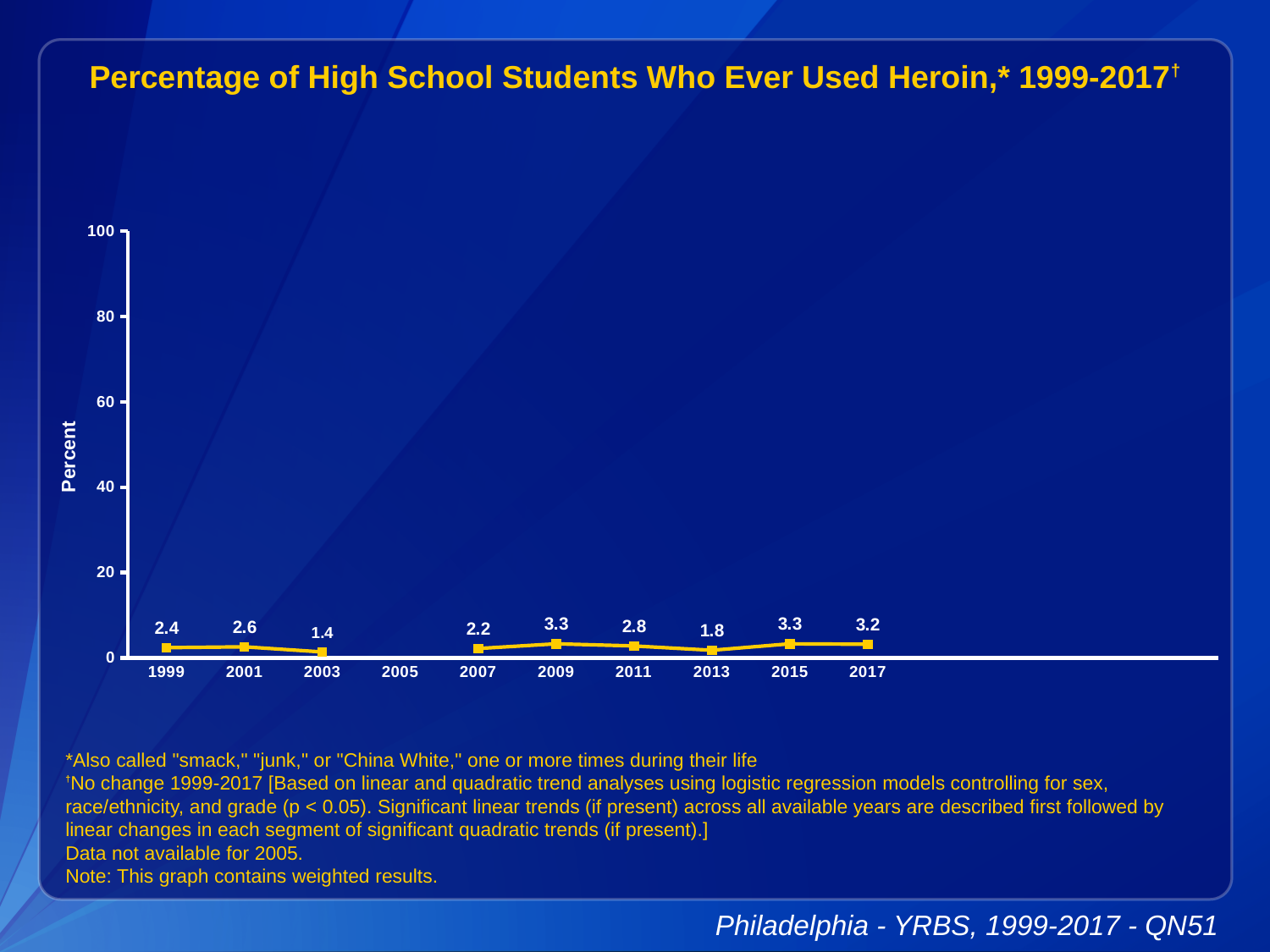
What is the difference between the values for 2001 and 1999? 0.2 What type of chart is shown on the slide? line chart How many years are labeled on the x axis? 10 What is the value shown for 2013? 1.8 Which year has the lowest percentage of students who ever used heroin? 2003 What is the highest value plotted on the chart? 3.3 Which year has the larger value, 2011 or 2013? 2011 Is the value for 2015 greater or less than 20? less What is the difference between the values for 2009 and 2003? 1.9 What is the label on the y axis? Percent What percentage of high school students reported ever using heroin in 1999? 2.4 What is the value shown for 2017? 3.2